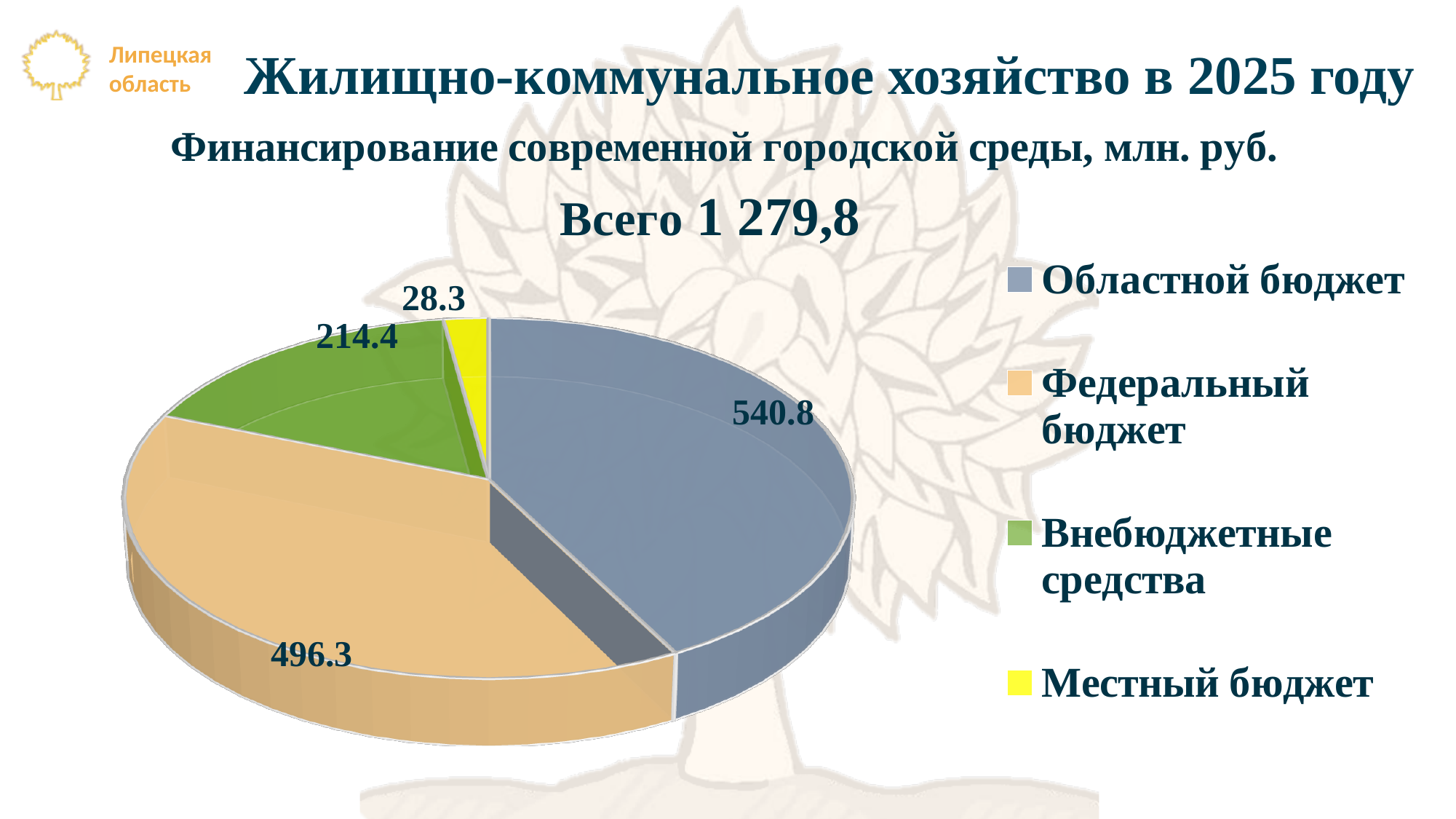
Which is larger: Федеральный бюджет or Внебюджетные средства? Федеральный бюджет What is the value for Федеральный бюджет? 496.3 What is the value for Областной бюджет? 540.8 What is the value for Местный бюджет? 28.3 What is the value for Внебюджетные средства? 214.4 Which category has the smallest slice of the pie? Местный бюджет Which category has the largest slice of the pie? Областной бюджет What is the difference between the values for Внебюджетные средства and Местный бюджет? 186.1 What type of chart is shown on the slide? Pie chart What is the difference between the values for Областной бюджет and Федеральный бюджет? 44.5 How many categories does the pie chart show? 4 What total is stated above the pie chart? 1 279,8